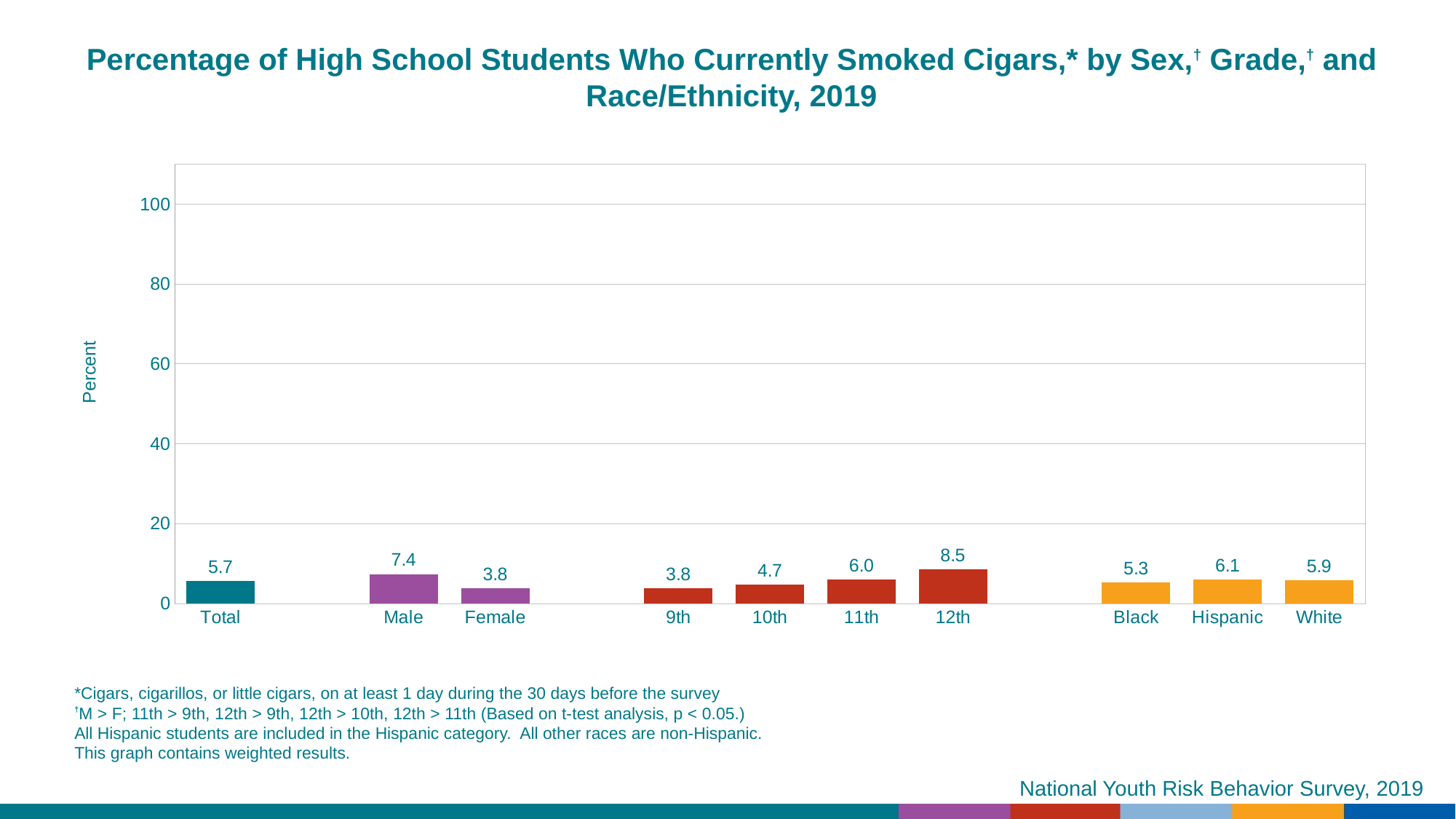
What is the value for 12th grade? 8.5 What is the value for Hispanic? 6.1 How many categories are shown on the x axis? 10 Is the value for 12th grade greater or less than 20? less What is the difference between the Male and Female values? 3.6 Which grade has the lowest value? 9th Which is larger, the value for Black or the value for White? White Which category has the highest value? 12th What is the value for Male? 7.4 Do the values rise or fall from 9th grade to 12th grade? rise What is the value for Total? 5.7 What kind of chart is this? bar chart